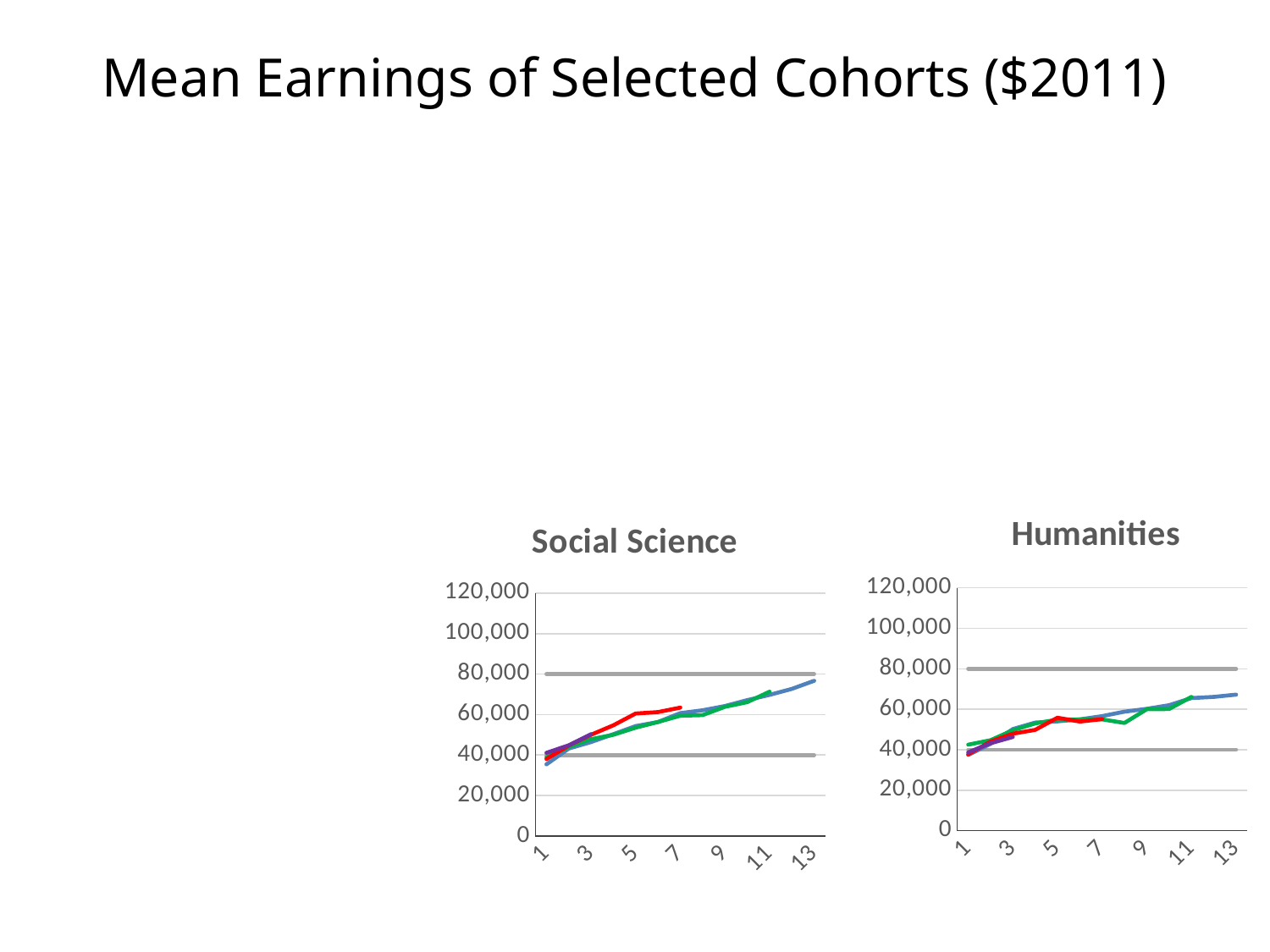
In the Social Science chart, is the value of the blue line at x = 13 greater or less than 60,000? greater In the Humanities chart, is the value of the green line at x = 1 greater or less than 60,000? less In the Social Science chart, is the value of the red line at x = 1 greater or less than 60,000? less How many charts are shown on the slide? 2 What kind of chart is the Humanities chart? line chart In the Social Science chart, do the coloured lines rise or fall as the x axis increases from 1 to 13? rise What is the highest value shown on the y axis of the Social Science chart? 120,000 What is the title of the chart on the right side of the slide? Humanities What kind of chart is the Social Science chart? line chart In the Humanities chart, do the coloured lines generally rise or fall from left to right? rise